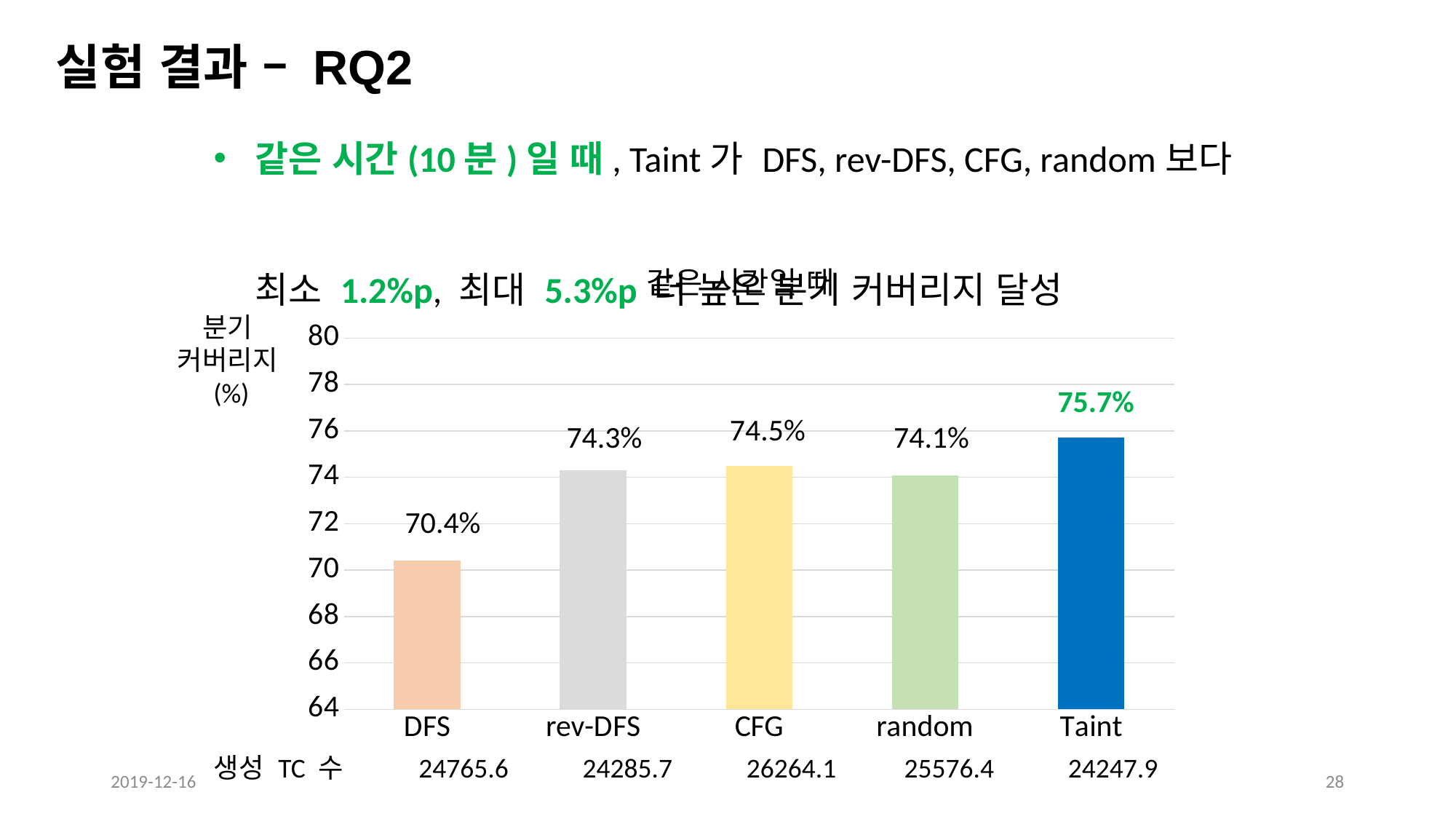
What is the branch coverage value shown for random? 74.1% What is the difference in branch coverage between Taint and DFS? 5.3% What kind of chart is shown on the slide? bar chart What is the difference in branch coverage between Taint and CFG? 1.2% Which category has the highest branch coverage? Taint Is the value for DFS greater or less than 72? less What is the branch coverage value shown for DFS? 70.4% Which category has the lowest branch coverage? DFS What is the branch coverage value shown for Taint? 75.7% How many categories are shown on the x axis of the chart? 5 Which has a higher branch coverage, rev-DFS or DFS? rev-DFS What is the branch coverage value shown for CFG? 74.5%